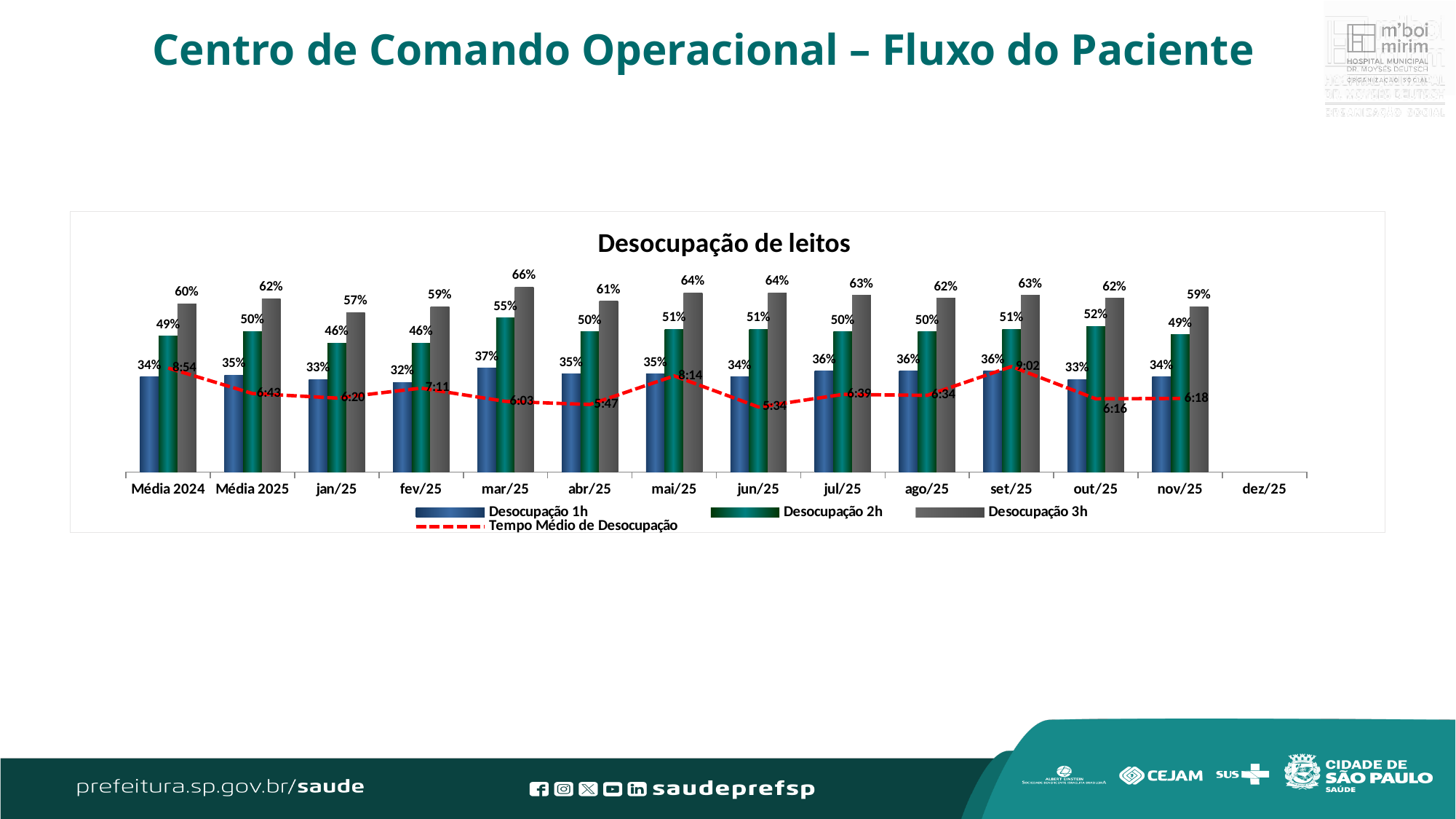
How many series does the legend list? 4 What is the Desocupação 2h value for out/25? 52% Which category has the lowest Tempo Médio de Desocupação value? jun/25 Which is larger, the Desocupação 2h value for mar/25 or for jan/25? mar/25 Which category has the highest Desocupação 3h value? mar/25 What is the title of the chart? Desocupação de leitos How many categories are shown on the x axis? 14 What kind of chart is this? Bar chart with a line What is the Tempo Médio de Desocupação value for set/25? 9:02 What is the Desocupação 3h value for mar/25? 66% What is the Desocupação 1h value for fev/25? 32% What is the difference between the Desocupação 3h values for Média 2025 and Média 2024? 2%